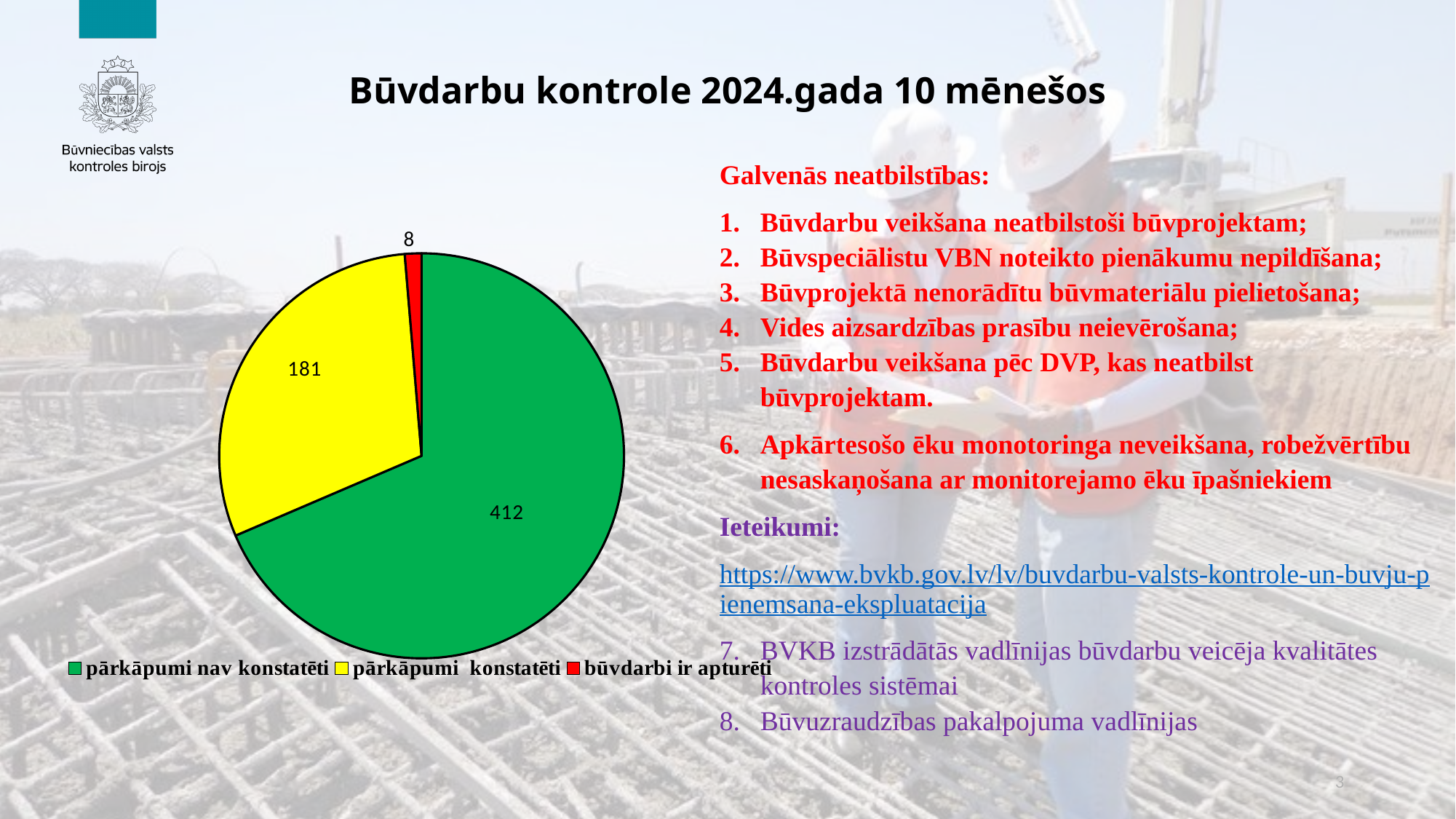
Which category has the largest slice in the pie chart? pārkāpumi nav konstatēti What is the difference between the values for "pārkāpumi nav konstatēti" and "pārkāpumi konstatēti"? 231 What colour is the slice for "pārkāpumi konstatēti"? yellow What is the value for "pārkāpumi nav konstatēti" in the pie chart? 412 Which is larger: the value for "pārkāpumi konstatēti" or the value for "būvdarbi ir apturēti"? pārkāpumi konstatēti What is the difference between the values for "pārkāpumi konstatēti" and "būvdarbi ir apturēti"? 173 What is the value for "būvdarbi ir apturēti" in the pie chart? 8 Which category has the smallest slice in the pie chart? būvdarbi ir apturēti What type of chart is shown on the slide? pie chart What is the total of all three slices in the pie chart? 601 How many slices does the pie chart have? 3 What is the value for "pārkāpumi konstatēti" in the pie chart? 181